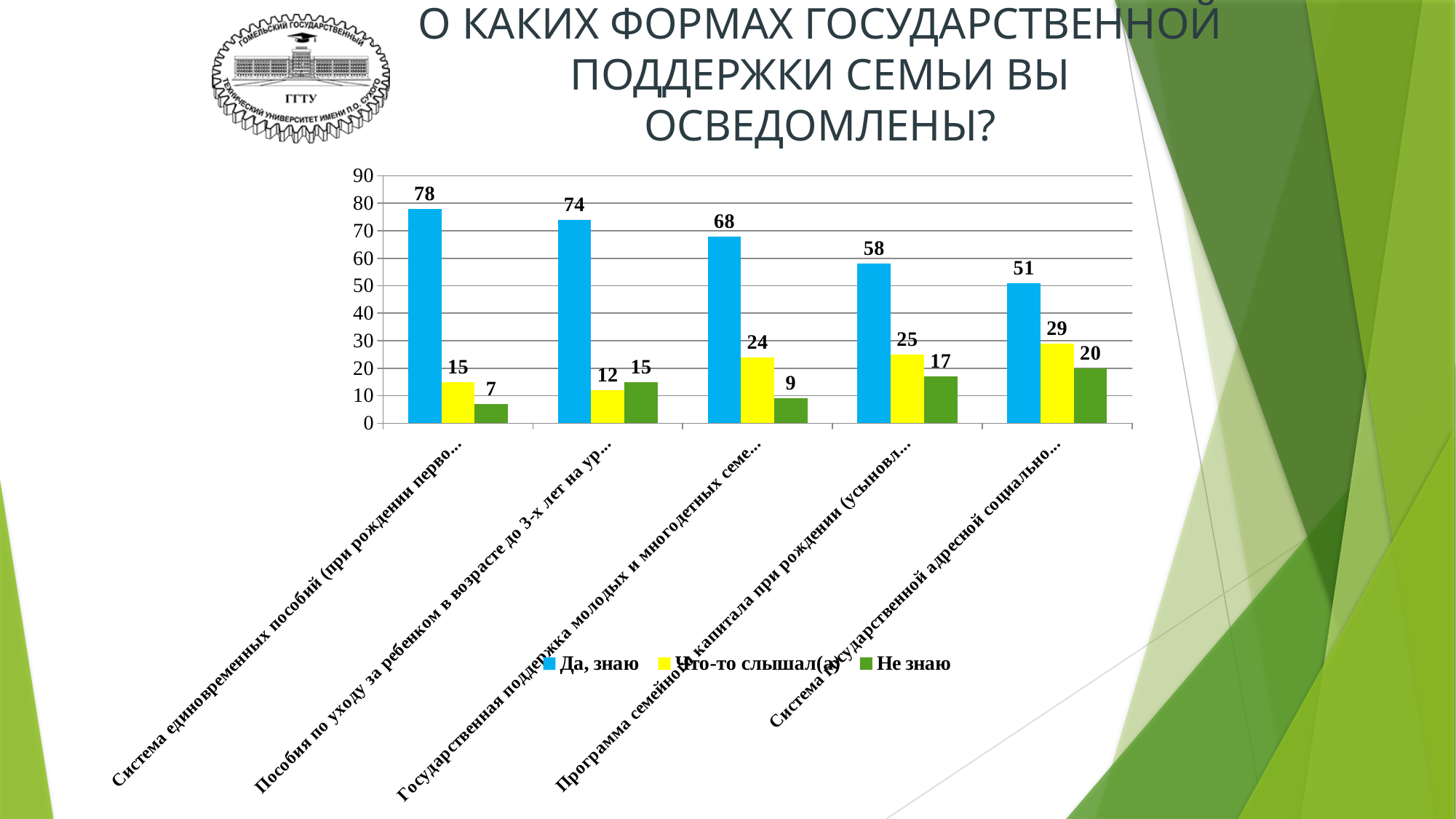
Which category has the highest value for "Да, знаю"? Система единовременных пособий (при рождении перво... What is the value of "Что-то слышал(а)" for the category "Программа семейного капитала при рождении (усыновл..."? 25 What colour are the bars for the series "Да, знаю"? blue What is the difference between the "Да, знаю" values for "Система единовременных пособий (при рождении перво..." and "Система государственной адресной социально..."? 27 What kind of chart is shown on the slide? bar chart Which is larger: "Что-то слышал(а)" or "Не знаю" for the category "Государственная поддержка молодых и многодетных семе..."? Что-то слышал(а) Do the "Да, знаю" values rise or fall from left to right along the x axis? fall How many series does the legend list? 3 Which category has the lowest value for "Не знаю"? Система единовременных пособий (при рождении перво... How many categories are plotted on the x axis? 5 What is the value of "Не знаю" for the category "Пособия по уходу за ребенком в возрасте до 3-х лет на ур..."? 15 What is the value of "Да, знаю" for the category "Система единовременных пособий (при рождении перво..."? 78